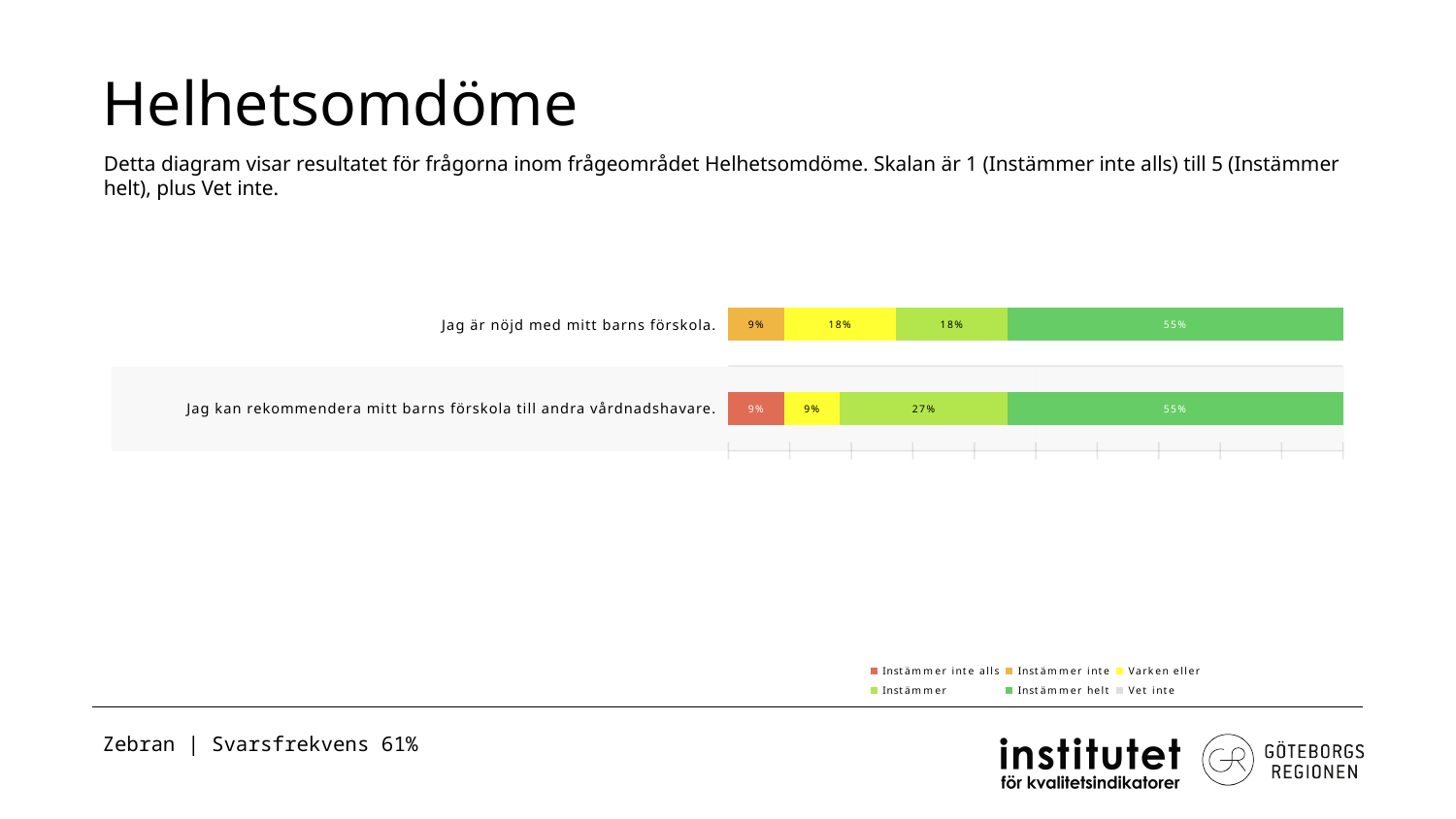
Which statement has the larger 'Varken eller' share? Jag är nöjd med mitt barns förskola. How many series does the legend list? 6 What kind of chart is shown on the slide? Stacked bar chart What is the difference in the 'Instämmer' share between 'Jag kan rekommendera mitt barns förskola till andra vårdnadshavare.' and 'Jag är nöjd med mitt barns förskola.'? 9 percentage points What is the 'Varken eller' share for 'Jag är nöjd med mitt barns förskola.'? 18% What is the 'Varken eller' share for 'Jag kan rekommendera mitt barns förskola till andra vårdnadshavare.'? 9% How many statements (categories) are plotted in the chart? 2 What is the 'Instämmer' share for 'Jag kan rekommendera mitt barns förskola till andra vårdnadshavare.'? 27% What is the 'Instämmer helt' share for 'Jag är nöjd med mitt barns förskola.'? 55% What is the total of the labelled segments in the bar for 'Jag är nöjd med mitt barns förskola.'? 100% Which response category is the largest segment in the bar for 'Jag kan rekommendera mitt barns förskola till andra vårdnadshavare.'? Instämmer helt Which legend entry is shown in dark green? Instämmer helt